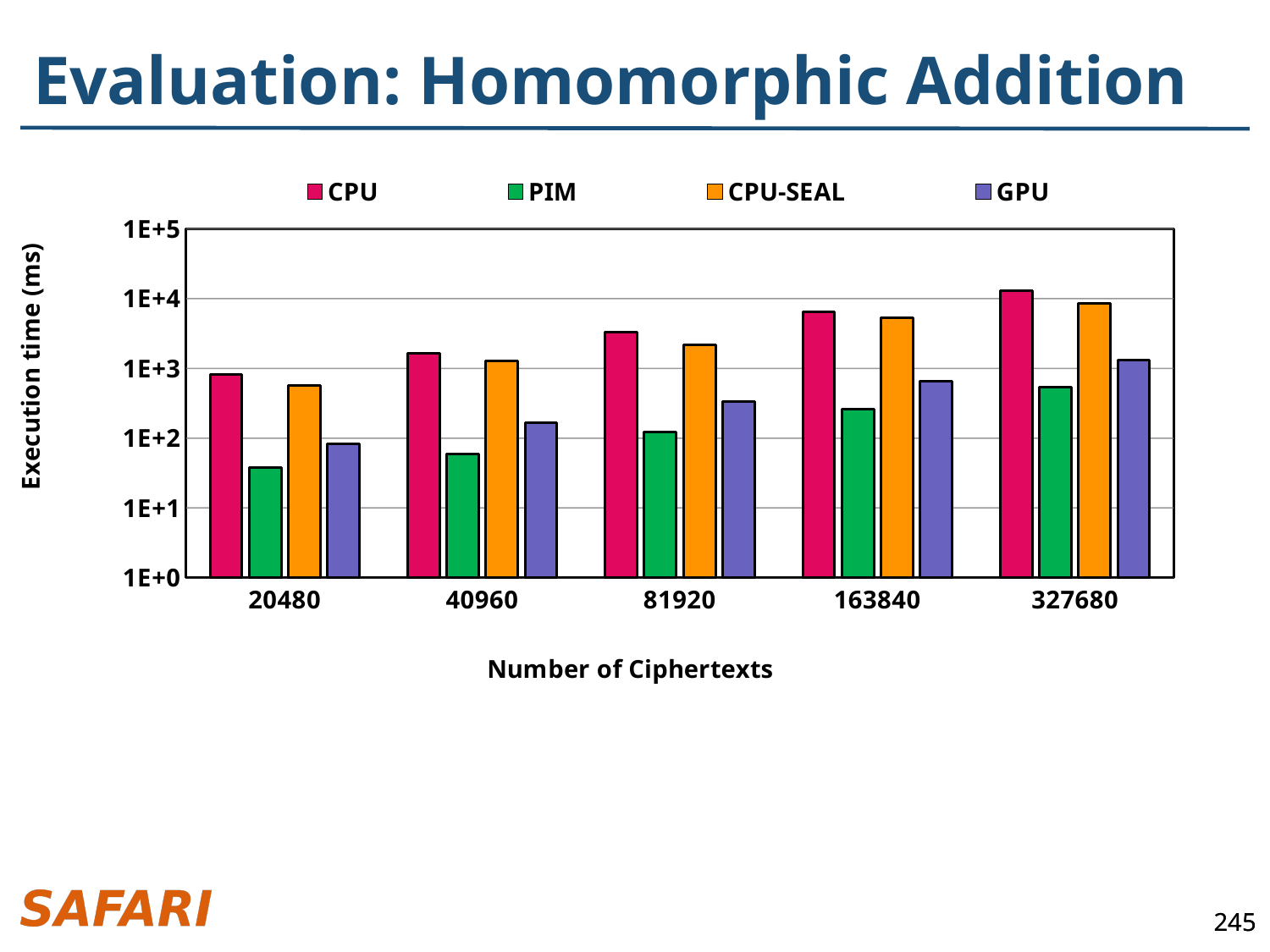
Is the value for GPU at 163840 ciphertexts greater or less than 1E+3? less Which series has the highest execution time at 327680 ciphertexts? CPU How many series does the legend list? 4 What kind of chart is shown on the slide? bar chart At 20480 ciphertexts, which is larger: the GPU bar or the PIM bar? GPU Is the value for PIM at 20480 ciphertexts greater or less than 1E+2? less Which series has the lowest execution time at 20480 ciphertexts? PIM Do the PIM execution times rise or fall as the number of ciphertexts increases? rise Is the value for CPU at 327680 ciphertexts greater or less than 1E+4? greater How many Number of Ciphertexts categories are shown on the x axis? 5 What is the label of the y axis? Execution time (ms) At 81920 ciphertexts, which is larger: the CPU bar or the CPU-SEAL bar? CPU